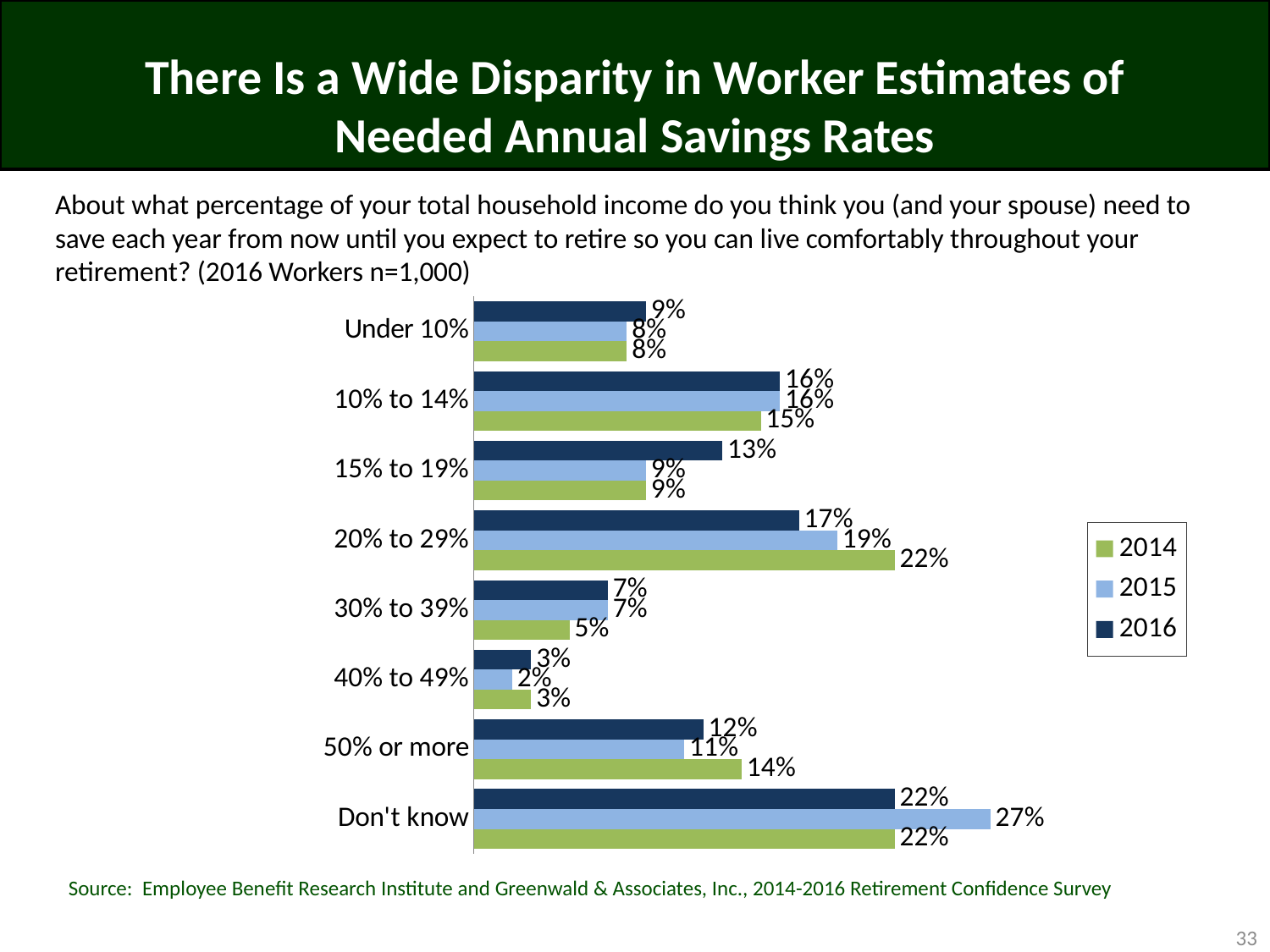
Which category has the highest 2015 value? Don't know How many categories are shown on the chart? 8 For the "50% or more" category, which year has the larger value, 2014 or 2015? 2014 What is the 2016 value for the "15% to 19%" category? 13% What kind of chart is shown on the slide? Bar chart Which colour represents the 2014 series in the legend? Green What is the 2015 value for the "Don't know" category? 27% What is the 2015 value for the "40% to 49%" category? 2% How many series does the legend list? 3 What is the 2014 value for the "20% to 29%" category? 22% What is the difference between the 2014 and 2016 values for the "20% to 29%" category? 5% Which category has the lowest 2016 value? 40% to 49%